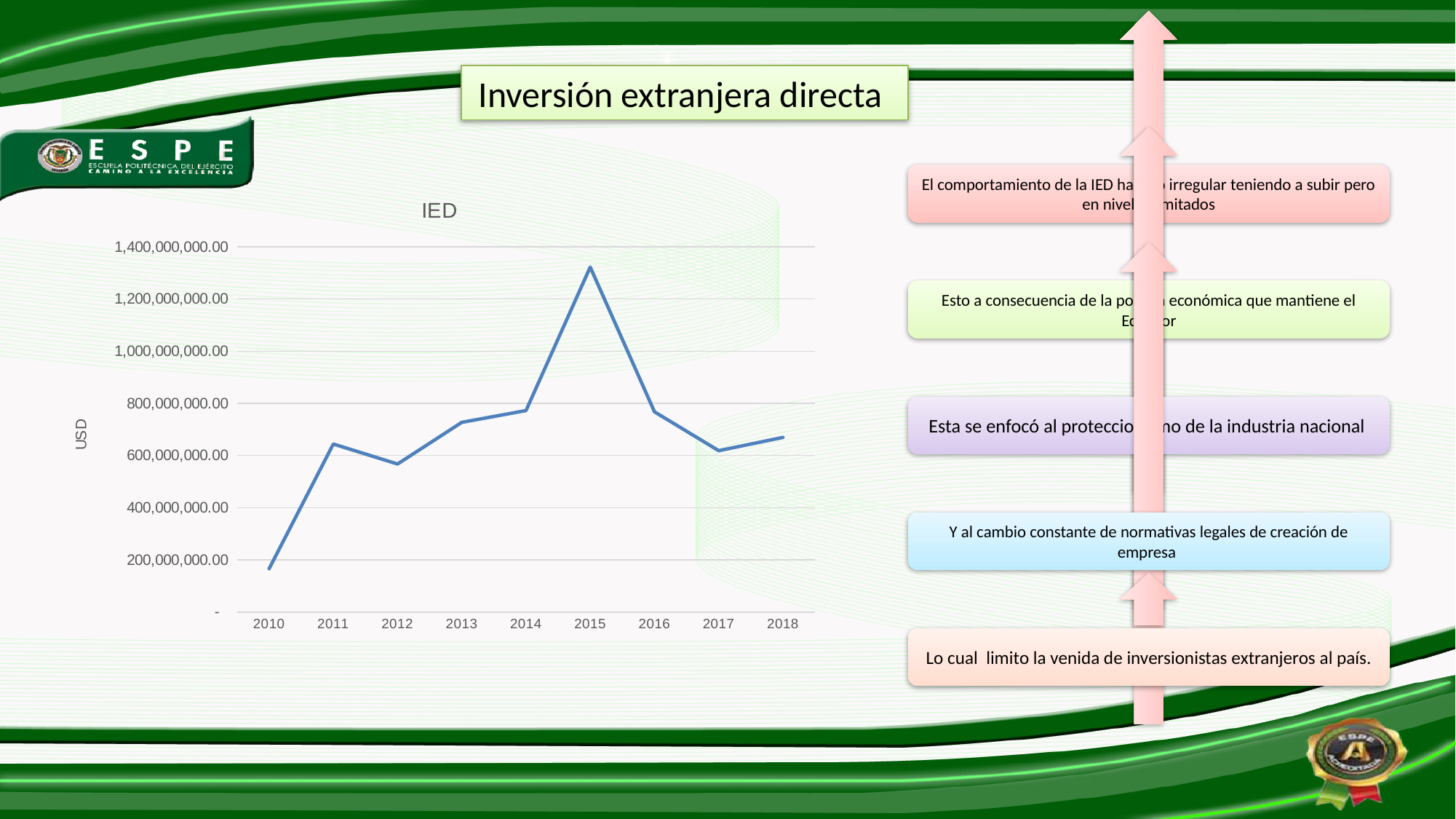
Which year has the highest IED value? 2015 Which year has a larger IED value, 2015 or 2016? 2015 Is the IED value for 2016 greater or less than 1,000,000,000.00? less What type of chart is shown on the slide? line chart What is the label on the vertical axis of the chart? USD Which year has a larger IED value, 2013 or 2011? 2013 Which year has the lowest IED value? 2010 Is the IED value for 2010 greater or less than 200,000,000.00? less Does the IED value rise or fall from 2015 to 2017? fall Is the IED value for 2015 greater or less than 1,200,000,000.00? greater How many years are plotted on the x axis of the chart? 9 What is the title of the chart? IED